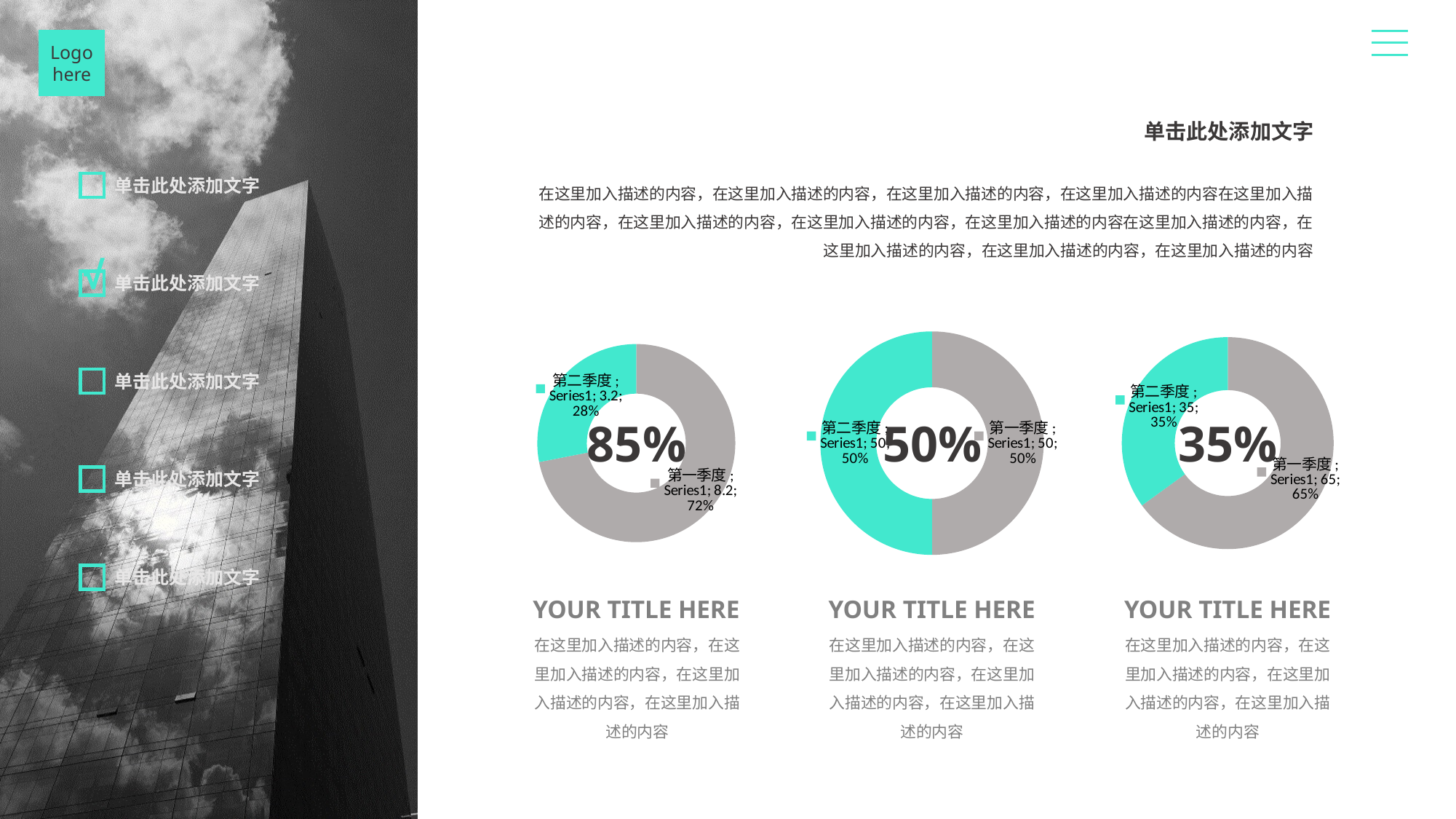
How many categories does the left doughnut chart show? 2 In the left doughnut chart, which category has the larger value, 第一季度 or 第二季度? 第一季度 In the right doughnut chart, what is the difference between the values for 第一季度 and 第二季度? 30 In the middle doughnut chart, what percentage share does 第一季度 have? 50% What type of chart is the middle chart on the slide? Doughnut chart In the right doughnut chart, what percentage share does 第二季度 have? 35% In the middle doughnut chart, what is the value for 第二季度? 50 In the right doughnut chart, what is the value for 第一季度? 65 In the left doughnut chart, what is the difference between the values for 第一季度 and 第二季度? 5 In the right doughnut chart, which category has the smallest value? 第二季度 In the left doughnut chart, what percentage share does 第二季度 have? 28% In the left doughnut chart, what is the value for 第一季度? 8.2